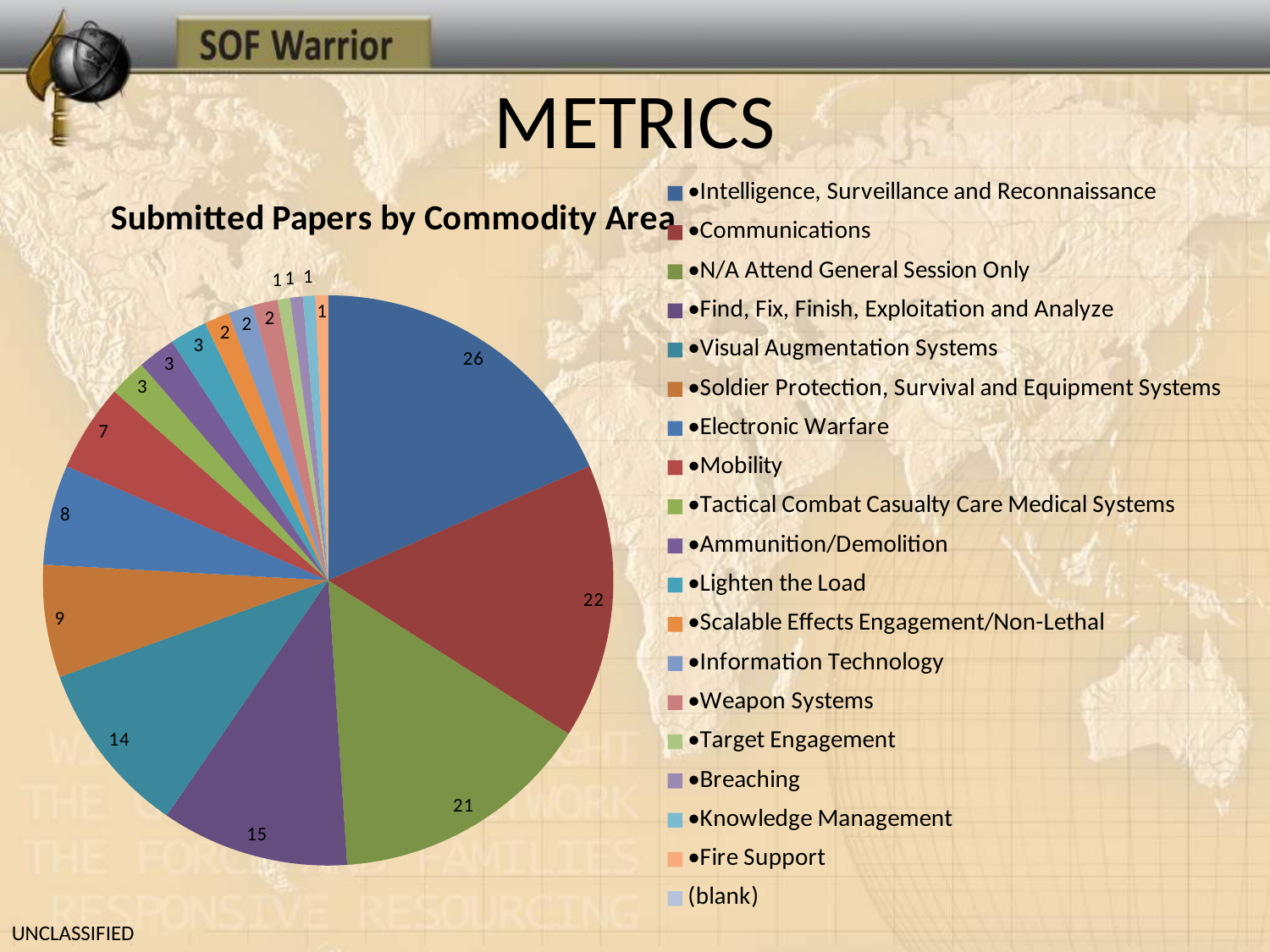
How many entries does the legend list? 19 Which commodity area has the most submitted papers? Intelligence, Surveillance and Reconnaissance What is the title of the chart? Submitted Papers by Commodity Area What kind of chart is shown on the slide? Pie chart What is the difference between the Intelligence, Surveillance and Reconnaissance value and the Communications value? 4 How many submitted papers are in the Communications commodity area? 22 What is the value for Soldier Protection, Survival and Equipment Systems? 9 What is the value for Visual Augmentation Systems? 14 What is the value for N/A Attend General Session Only? 21 Which has more submitted papers, Electronic Warfare or Mobility? Electronic Warfare How many submitted papers are in the Intelligence, Surveillance and Reconnaissance commodity area? 26 What is the value for Find, Fix, Finish, Exploitation and Analyze? 15